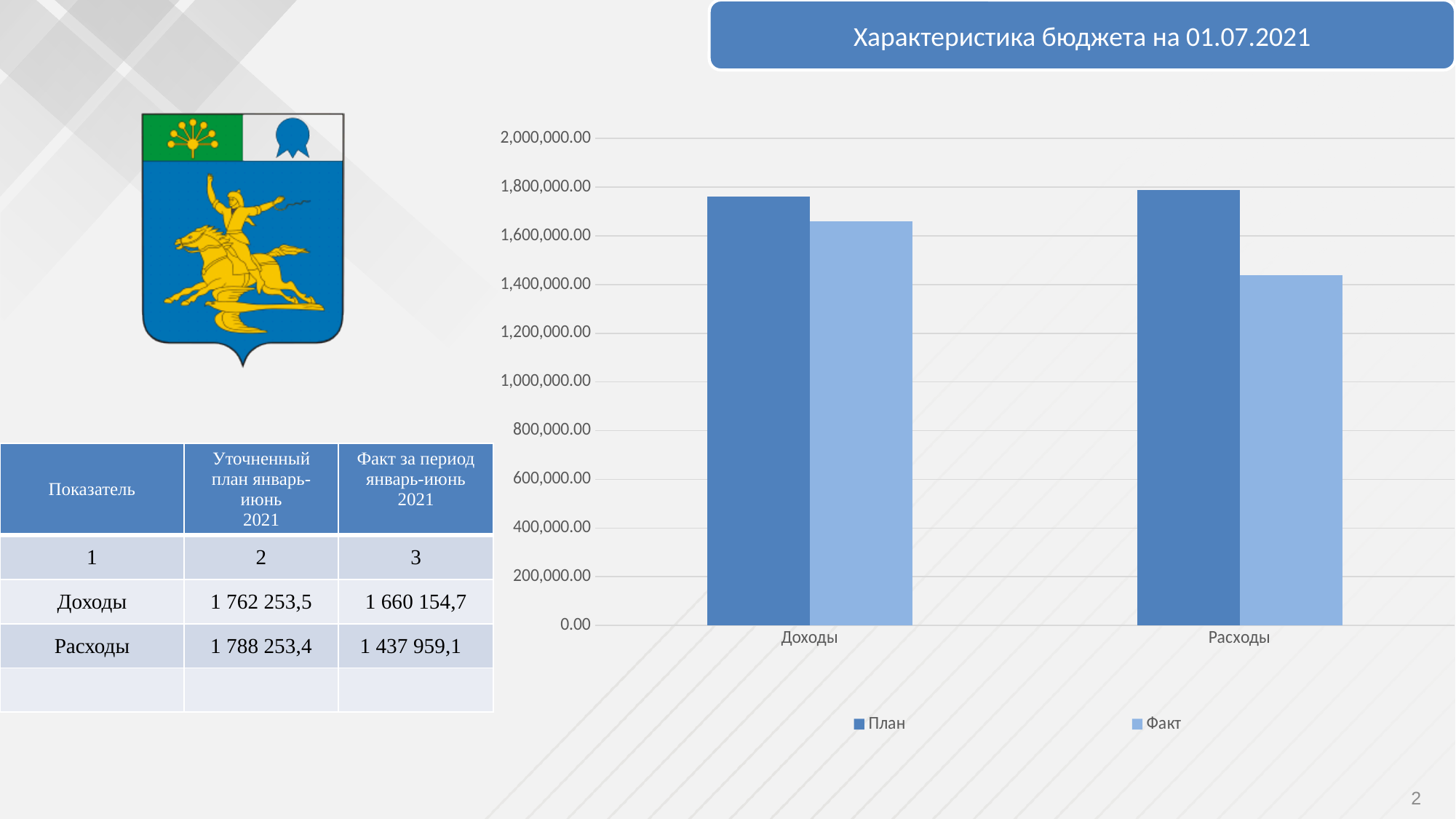
How many series does the chart legend list? 2 Which category has the larger Факт value: Доходы or Расходы? Доходы Which series does the chart legend list first? План Is the Факт value for Расходы greater or less than 1,600,000.00? less For Доходы, which is larger: План or Факт? План Is the План value for Доходы greater or less than 1,800,000.00? less What kind of chart is shown on the slide? bar chart According to the table on the slide, what is the Факт value for Расходы plotted in the chart? 1 437 959,1 For Расходы, which is larger: План or Факт? План Which bar is the lowest in the chart? Факт for Расходы How many categories are shown on the x axis of the chart? 2 Is the Факт value for Доходы greater or less than 1,600,000.00? greater